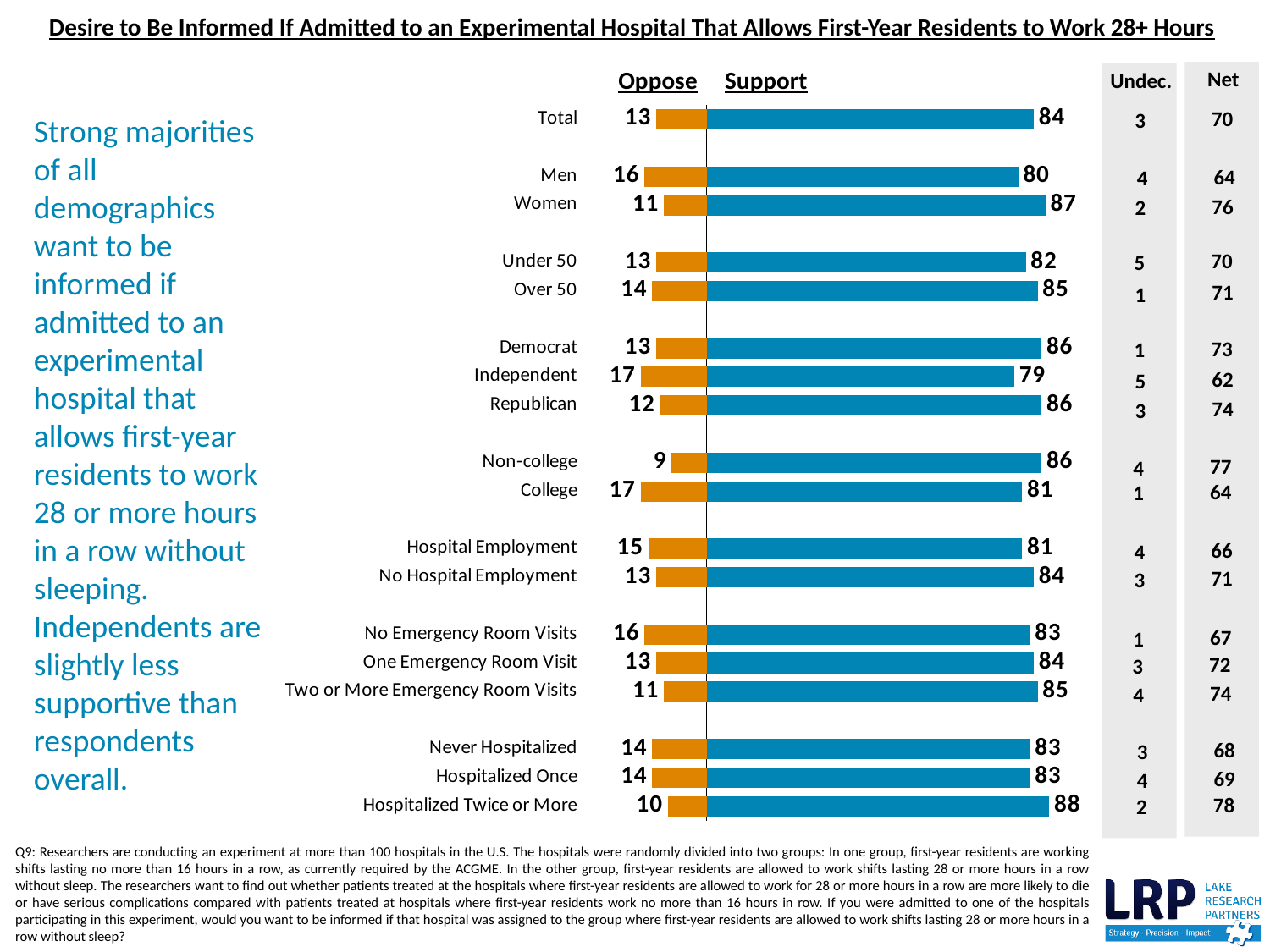
What kind of chart is shown on the slide? Bar chart Which has a larger Support value, Under 50 or Over 50? Over 50 What is the Oppose value for Hospitalized Twice or More? 10 What is the difference between the Oppose values for College and Non-college? 8 Which category has the lowest Oppose value? Non-college What is the difference between the Support values for Women and Men? 7 Which category has the highest Support value? Hospitalized Twice or More How many categories are plotted in the chart? 18 How many series does the chart show? 2 What is the Oppose value for Independent? 17 Which category has the lowest Support value? Independent What is the Support value for Total? 84